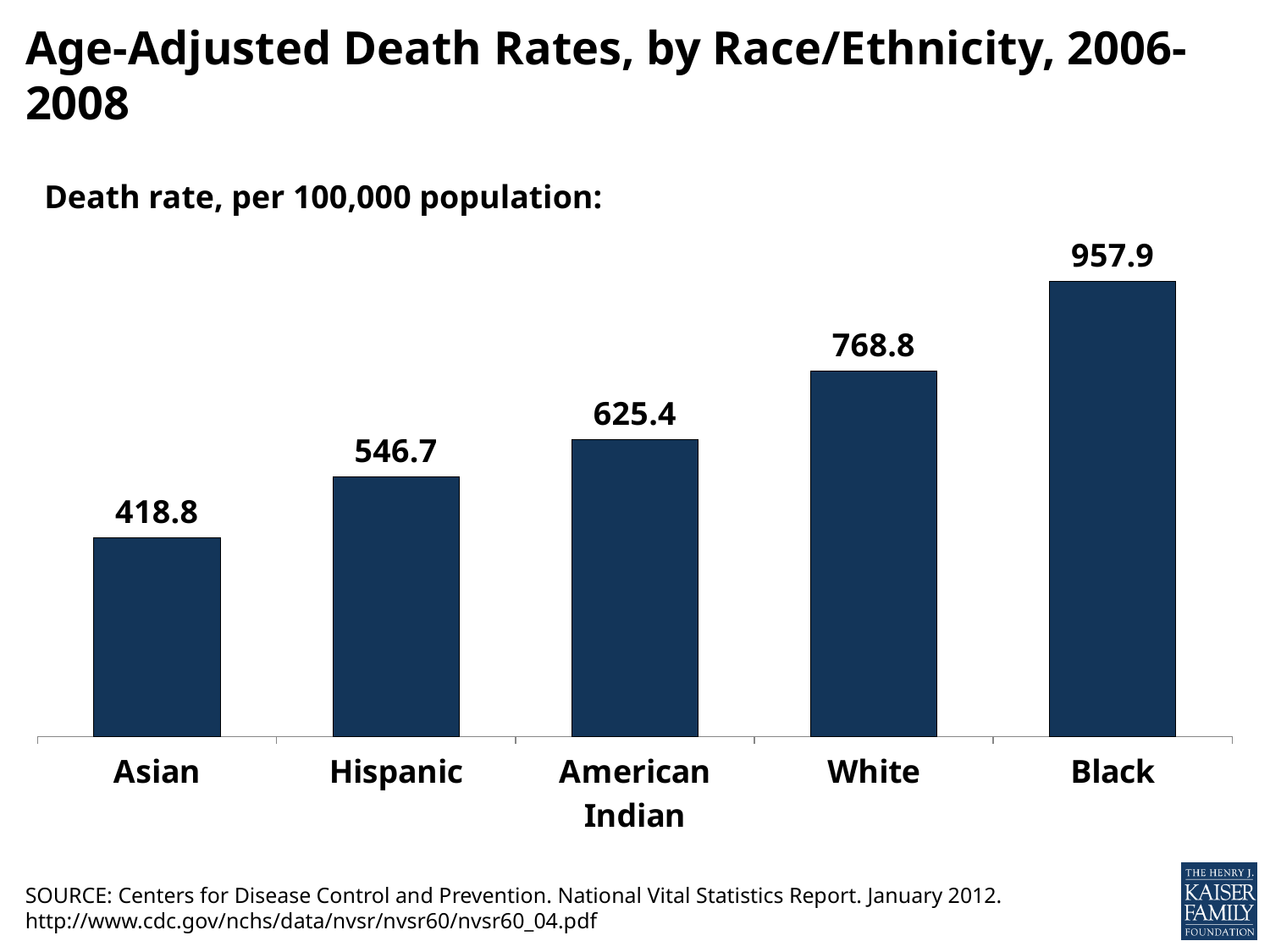
In what unit are the death rates expressed, according to the chart subtitle? Per 100,000 population What is the age-adjusted death rate for Asian? 418.8 Which race/ethnicity has the lowest age-adjusted death rate? Asian What is the age-adjusted death rate for American Indian? 625.4 What is the difference between the death rates for Hispanic and Asian? 127.9 What is the age-adjusted death rate for White? 768.8 Which race/ethnicity has the highest age-adjusted death rate? Black Which has a higher death rate, Hispanic or American Indian? American Indian What is the difference between the death rates for Black and White? 189.1 What kind of chart is shown on the slide? Bar chart How many race/ethnicity categories are shown in the chart? 5 Do the death rates rise or fall moving from left to right across the categories? Rise